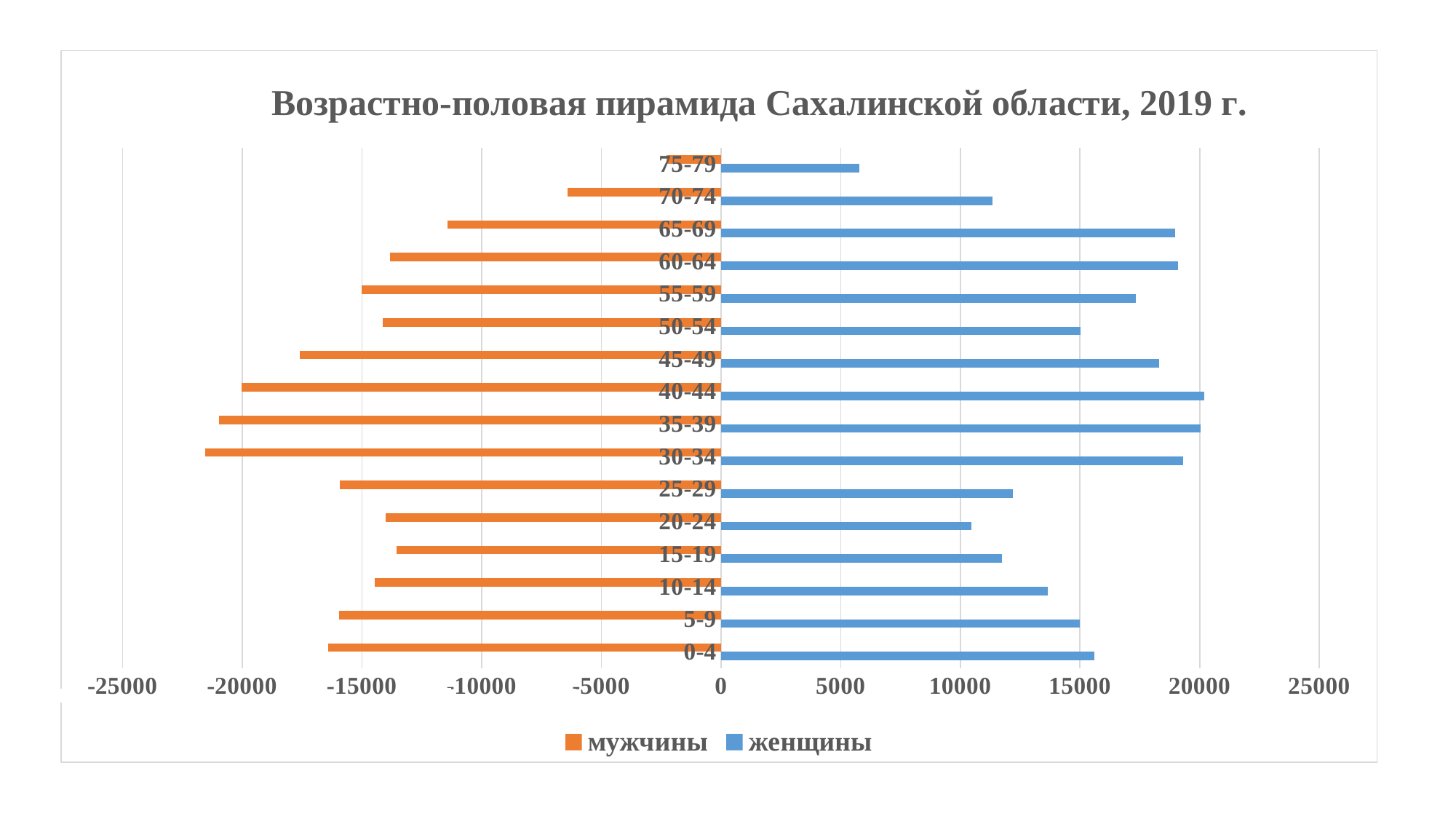
What is the title of the chart? Возрастно-половая пирамида Сахалинской области, 2019 г. Which age group has the shortest bar for мужчины? 75-79 Is the value for мужчины in the 65-69 age group greater or less than -15000? greater Which age group has the larger value for женщины, 65-69 or 70-74? 65-69 Is the value for женщины in the 75-79 age group greater or less than 5000? greater How many series does the legend list? 2 Is the value for мужчины in the 30-34 age group greater or less than -20000? less How many age groups are shown on the chart? 16 What kind of chart is shown on the slide? bar chart Which age group has the lowest value for женщины? 75-79 Which colour represents the series мужчины? orange